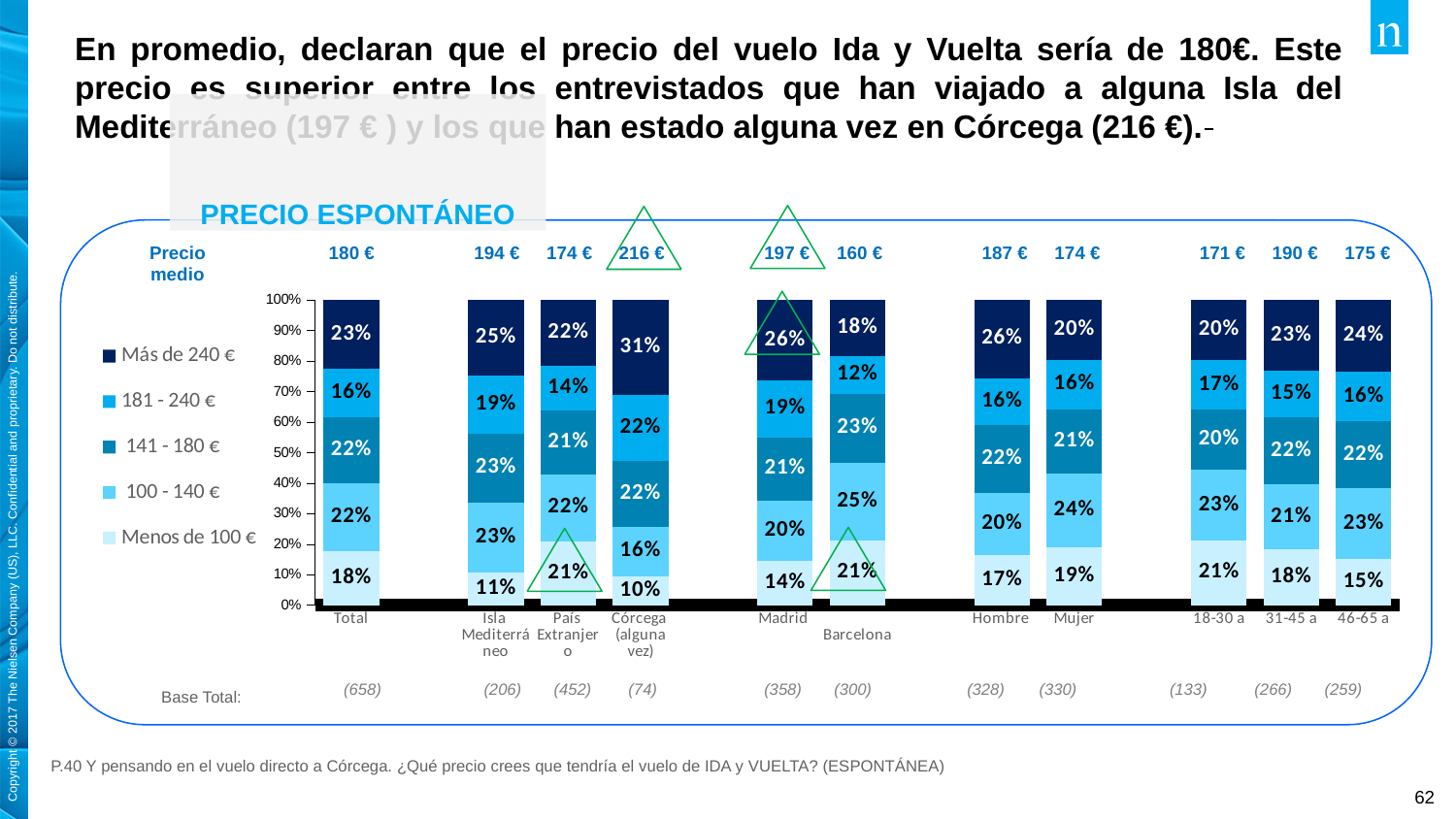
What is the value for 'Menos de 100 €' in the Total bar? 18% What kind of chart is shown on the slide? Stacked bar chart Which category has the highest 'Más de 240 €' share? Córcega (alguna vez) How many categories (bars) are plotted in the chart? 11 What is the value for '100 - 140 €' in the Barcelona bar? 25% Which is larger: the 'Menos de 100 €' share for Hombre or for Mujer? Mujer Which category has the lowest 'Menos de 100 €' share? Córcega (alguna vez) How many series does the legend list? 5 What is the 'Precio medio' shown above the Córcega (alguna vez) bar? 216 € What is the difference between the 'Más de 240 €' share for Madrid and for Barcelona? 8% What is the title of the chart? PRECIO ESPONTÁNEO What is the value for 'Más de 240 €' in the Córcega (alguna vez) bar? 31%